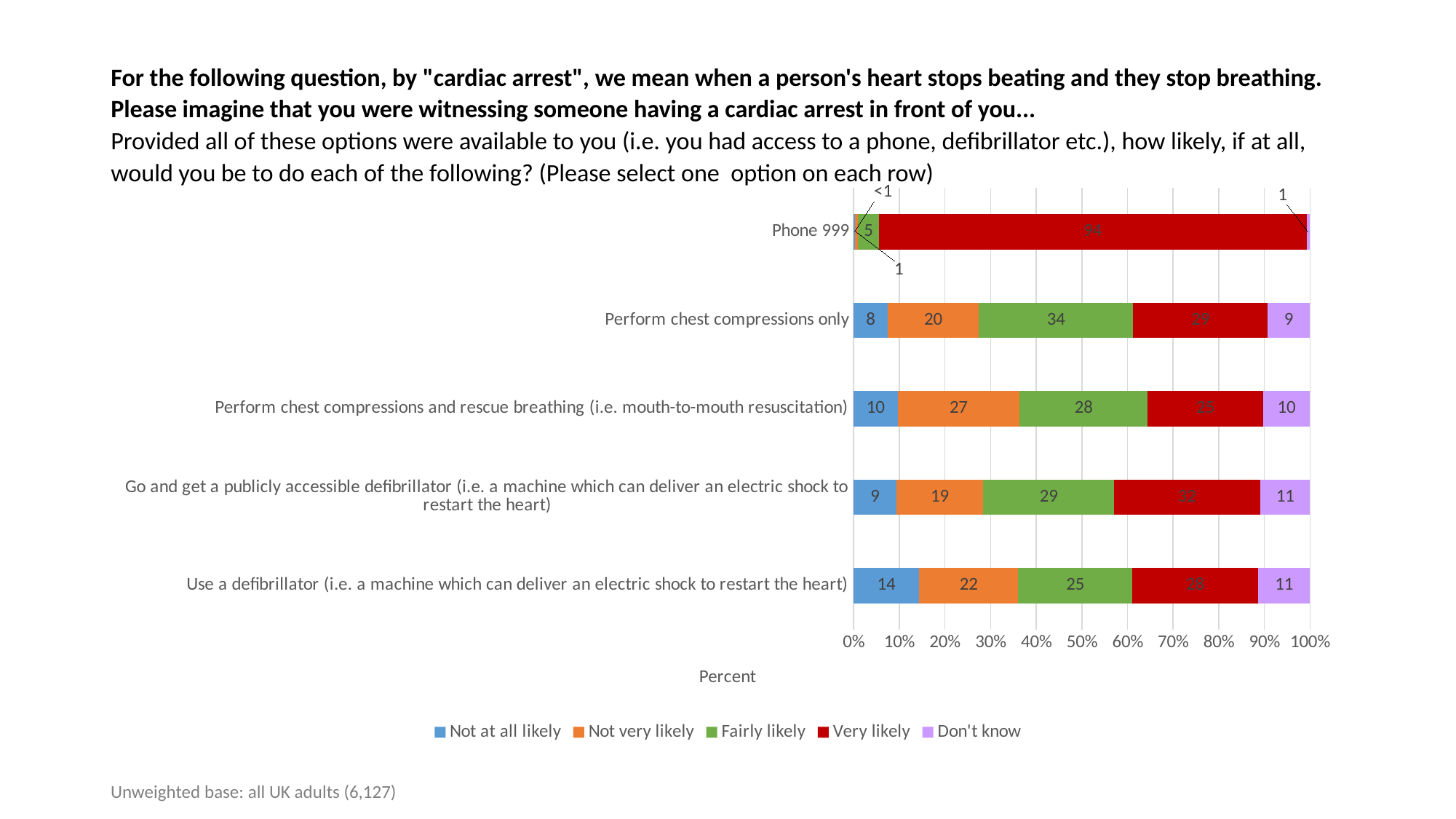
What is the "Not at all likely" value for "Use a defibrillator (i.e. a machine which can deliver an electric shock to restart the heart)"? 14 Which is larger: the "Not very likely" value for "Perform chest compressions only" or for "Use a defibrillator"? Use a defibrillator Which category has the highest "Very likely" value? Phone 999 What kind of chart is shown on the slide? Stacked bar chart Which category has the lowest "Not at all likely" value? Phone 999 What is the label on the horizontal axis of the chart? Percent What is the "Very likely" value for "Phone 999"? 94 What is the "Fairly likely" value for "Perform chest compressions only"? 34 How many categories (rows) are plotted in the chart? 5 What is the "Not very likely" value for "Perform chest compressions and rescue breathing (i.e. mouth-to-mouth resuscitation)"? 27 How many series does the legend list? 5 What is the difference between the "Very likely" values for "Go and get a publicly accessible defibrillator" and "Use a defibrillator"? 4